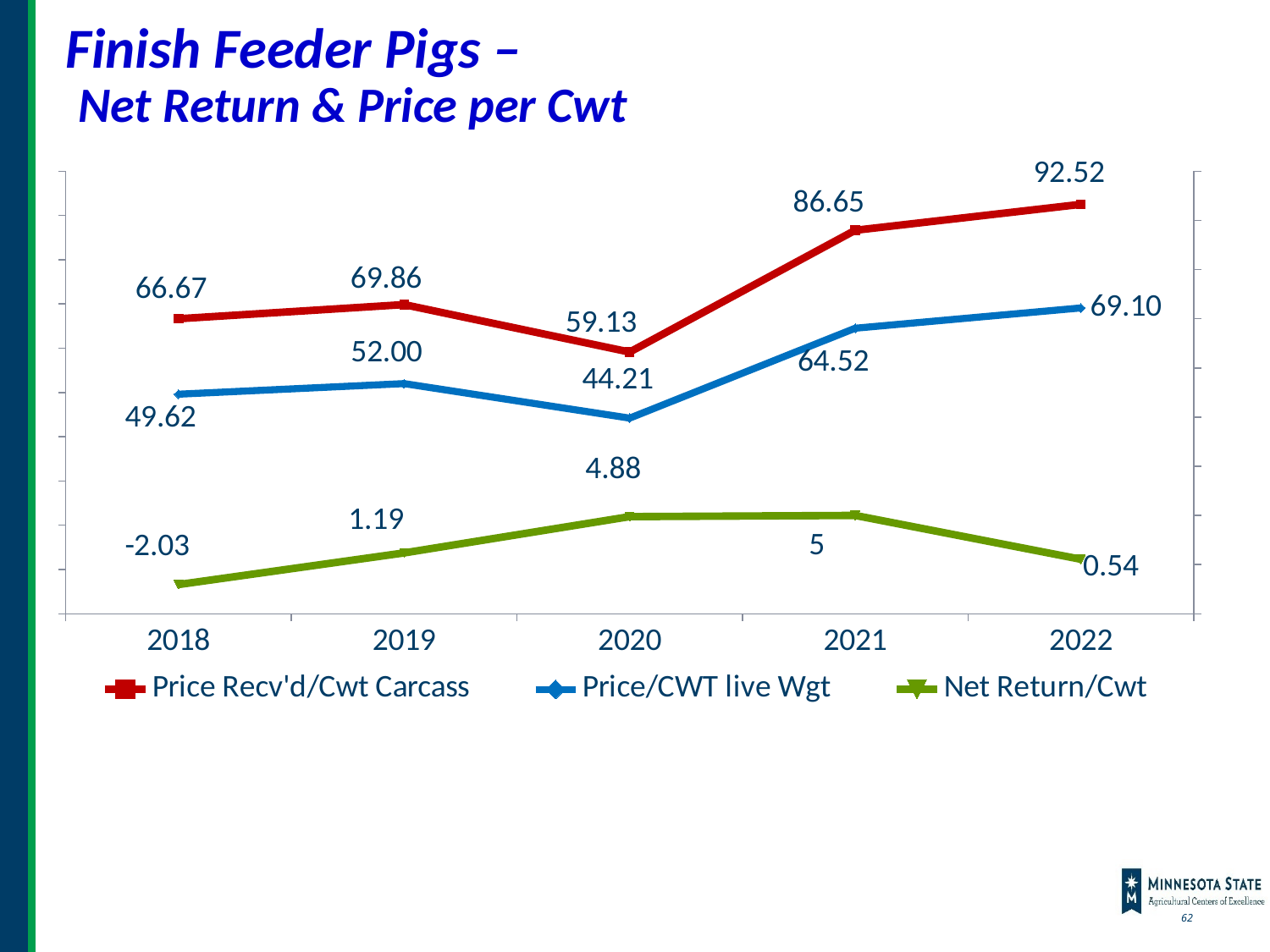
Which is larger, the Price/CWT live Wgt value in 2019 or in 2022? 2022 How many series does the legend list? 3 What kind of chart is shown on the slide? Line chart What is the Price Recv'd/Cwt Carcass value for 2022? 92.52 In which year is Net Return/Cwt highest? 2021 What is the difference between Price Recv'd/Cwt Carcass and Price/CWT live Wgt in 2021? 22.13 In which year is Price Recv'd/Cwt Carcass lowest? 2020 Does Price Recv'd/Cwt Carcass rise or fall from 2020 to 2022? Rise What is the Net Return/Cwt value for 2018? -2.03 Which series is drawn in green? Net Return/Cwt How many years are shown on the x axis? 5 What is the Price/CWT live Wgt value for 2020? 44.21